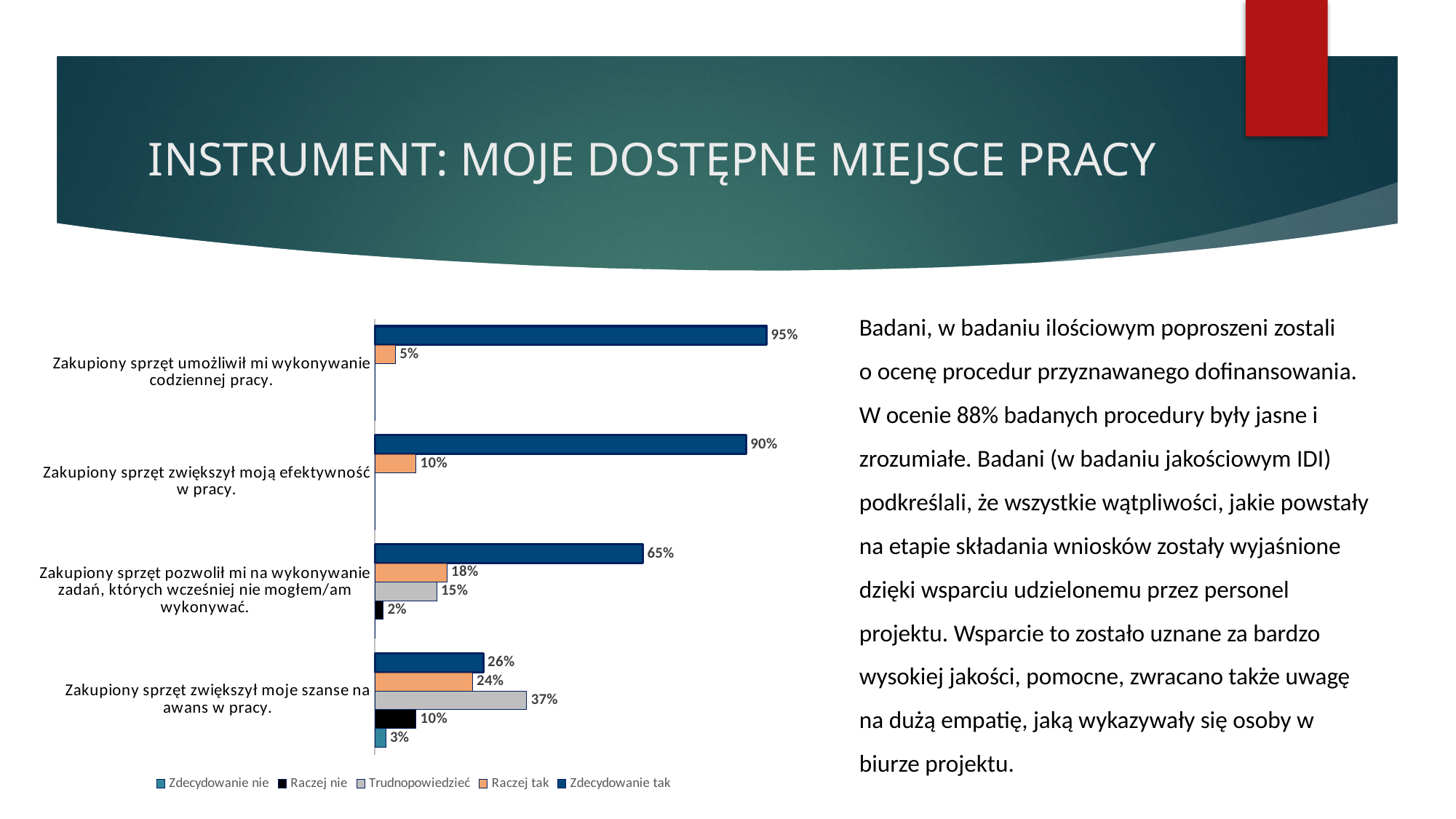
What is the difference between the 'Zdecydowanie tak' values for 'Zakupiony sprzęt umożliwił mi wykonywanie codziennej pracy.' and 'Zakupiony sprzęt zwiększył moją efektywność w pracy.'? 5% How many categories (statements) are shown on the chart? 4 Which series is the only one with a value for 'Zdecydowanie nie', and what is that value? Zakupiony sprzęt zwiększył moje szanse na awans w pracy., 3% What is the 'Zdecydowanie tak' value for 'Zakupiony sprzęt umożliwił mi wykonywanie codziennej pracy.'? 95% For 'Zakupiony sprzęt zwiększył moje szanse na awans w pracy.', which is larger: 'Zdecydowanie tak' or 'Trudno powiedzieć'? Trudno powiedzieć Which statement has the lowest 'Zdecydowanie tak' value? Zakupiony sprzęt zwiększył moje szanse na awans w pracy. What is the 'Raczej nie' value for 'Zakupiony sprzęt pozwolił mi na wykonywanie zadań, których wcześniej nie mogłem/am wykonywać.'? 2% What type of chart is shown on the slide? bar chart How many series does the legend list? 5 What is the 'Raczej tak' value for 'Zakupiony sprzęt zwiększył moją efektywność w pracy.'? 10% Which statement has the highest 'Zdecydowanie tak' value? Zakupiony sprzęt umożliwił mi wykonywanie codziennej pracy. What is the 'Trudno powiedzieć' value for 'Zakupiony sprzęt zwiększył moje szanse na awans w pracy.'? 37%